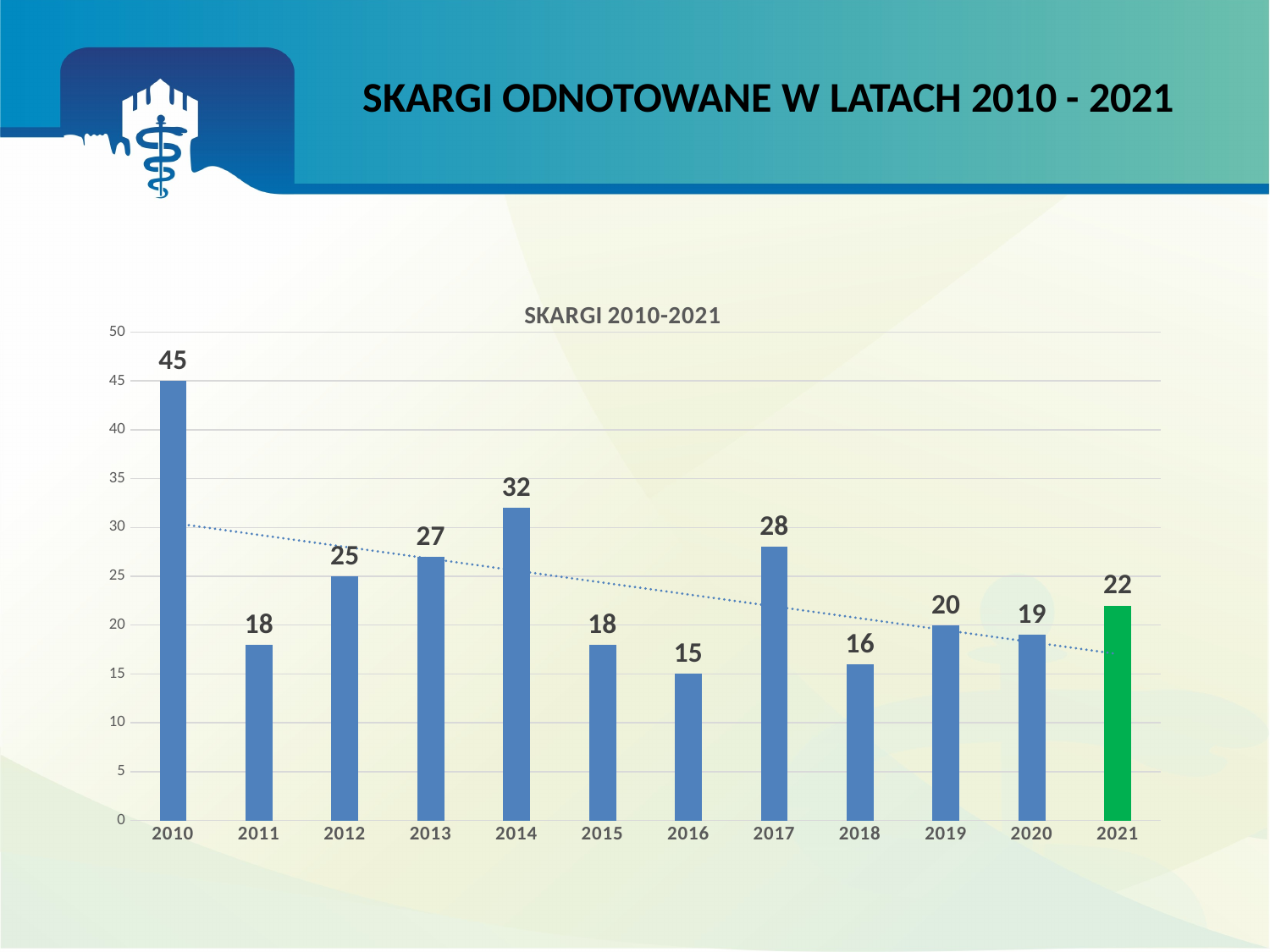
What kind of chart is this? bar chart What is the title of the chart? SKARGI 2010-2021 What is the value for 2016? 15 Which is larger, the value for 2013 or the value for 2019? 2013 What is the value for 2021? 22 Which year has the highest value? 2010 What is the difference between the values for 2014 and 2017? 4 Which year has the lowest value? 2016 How many years are shown on the x axis? 12 What is the difference between the values for 2010 and 2011? 27 Is the value for 2014 greater or less than 30? greater What is the value for 2010? 45